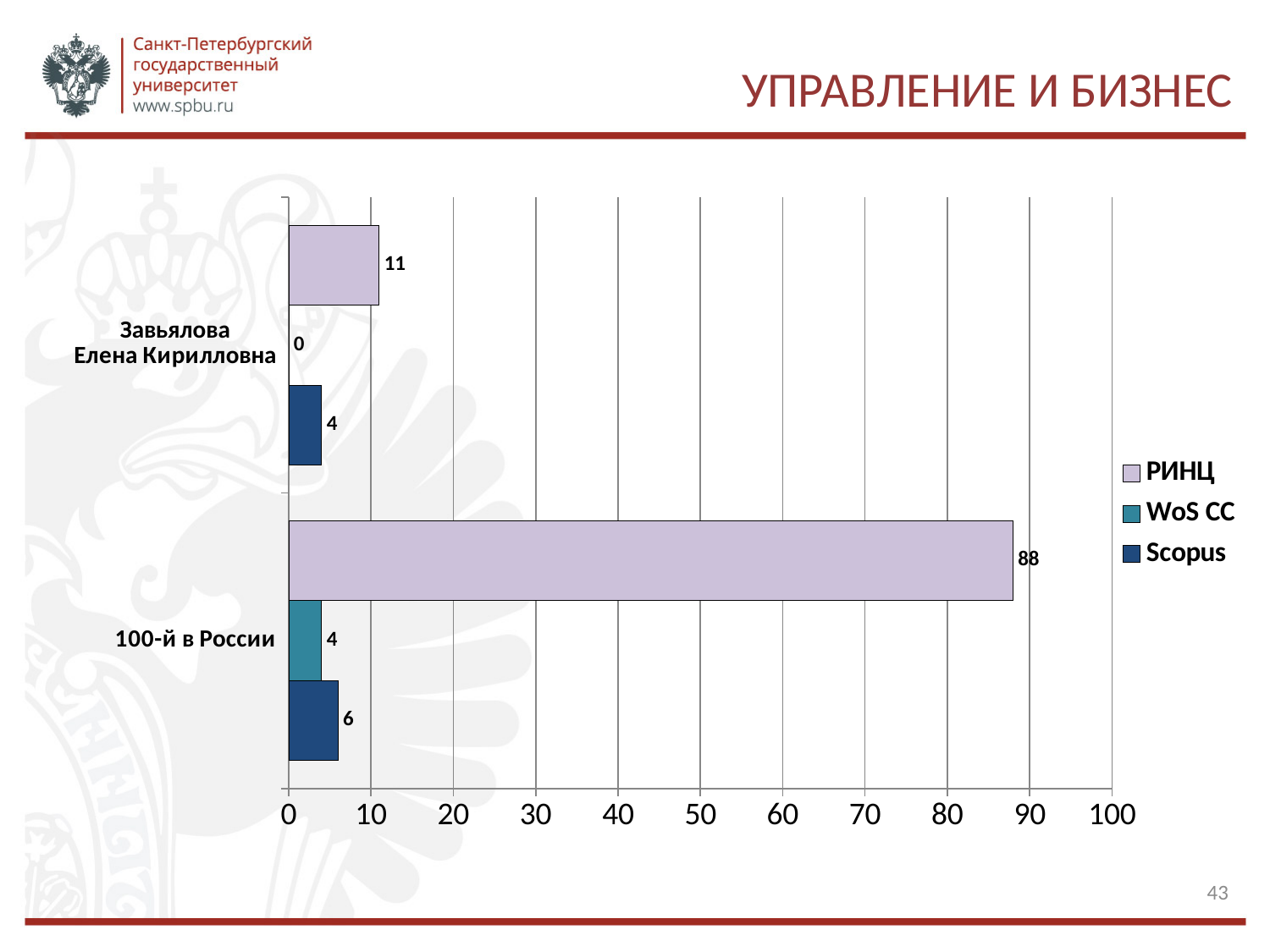
What is the Scopus value for Завьялова Елена Кирилловна? 4 What is the WoS CC value for Завьялова Елена Кирилловна? 0 What is the WoS CC value for 100-й в России? 4 What is the РИНЦ value for 100-й в России? 88 How many series does the legend list? 3 What is the Scopus value for 100-й в России? 6 What kind of chart is shown on the slide? Bar chart Which is larger: the Scopus value for 100-й в России or the Scopus value for Завьялова Елена Кирилловна? 100-й в России What is the difference between the РИНЦ values for 100-й в России and Завьялова Елена Кирилловна? 77 Which series has the highest value for 100-й в России? РИНЦ What is the РИНЦ value for Завьялова Елена Кирилловна? 11 How many categories are shown on the chart? 2